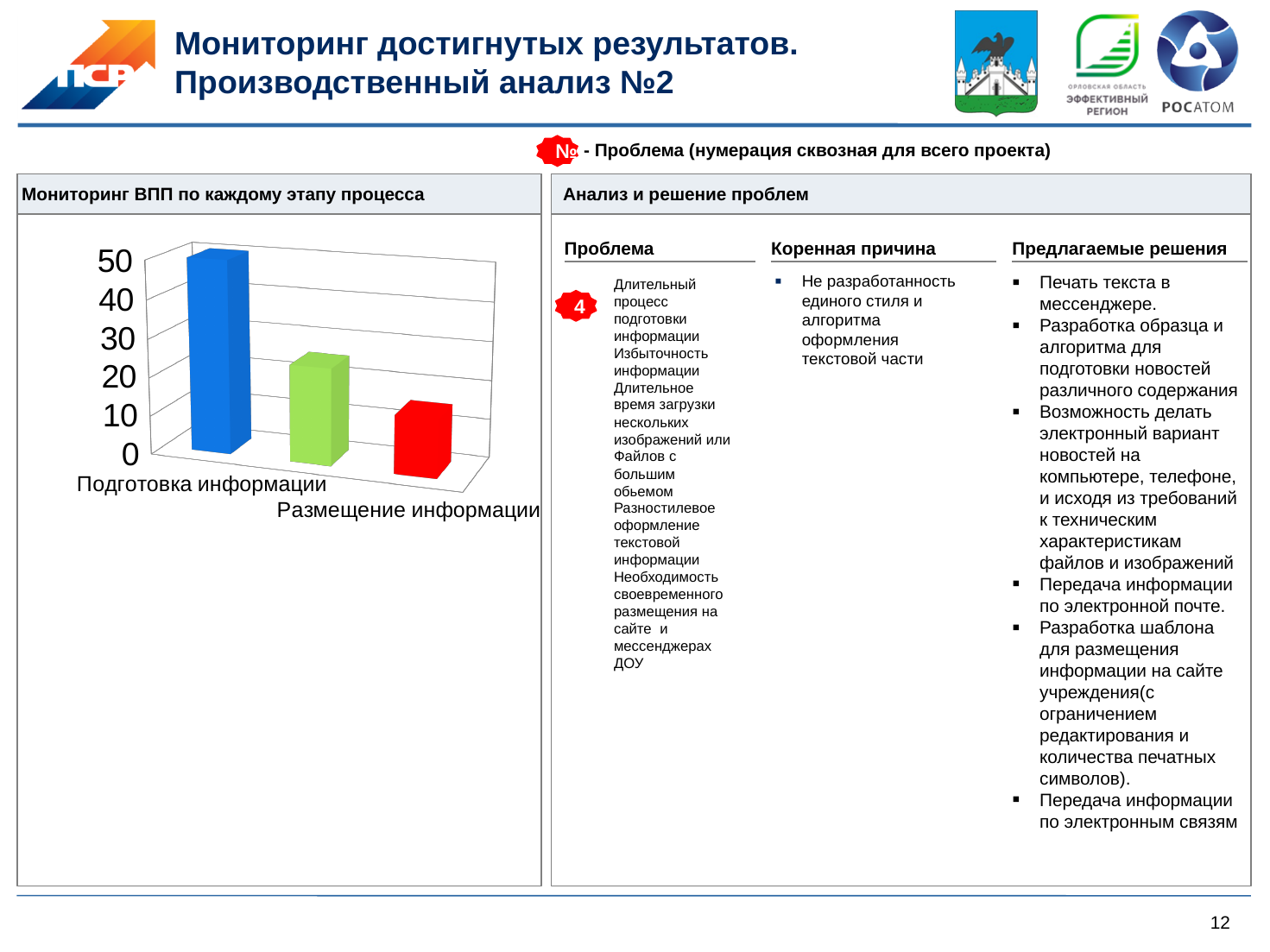
Which category has the tallest bar in the chart? Подготовка информации Is the value for "Размещение информации" greater or less than 40? less Which is larger, the value for "Подготовка информации" or the value for "Размещение информации"? Подготовка информации Do the bar values rise or fall from left to right across the chart? fall What is the highest value shown on the vertical axis of the chart? 50 Is the value of the red bar greater or less than 30? less Is the value for "Подготовка информации" greater or less than 40? greater How many bars are plotted in the chart? 3 What kind of chart is shown under "Мониторинг ВПП по каждому этапу процесса"? bar chart Which bar is the shortest in the chart? the red bar What colour is the tallest bar in the chart? blue